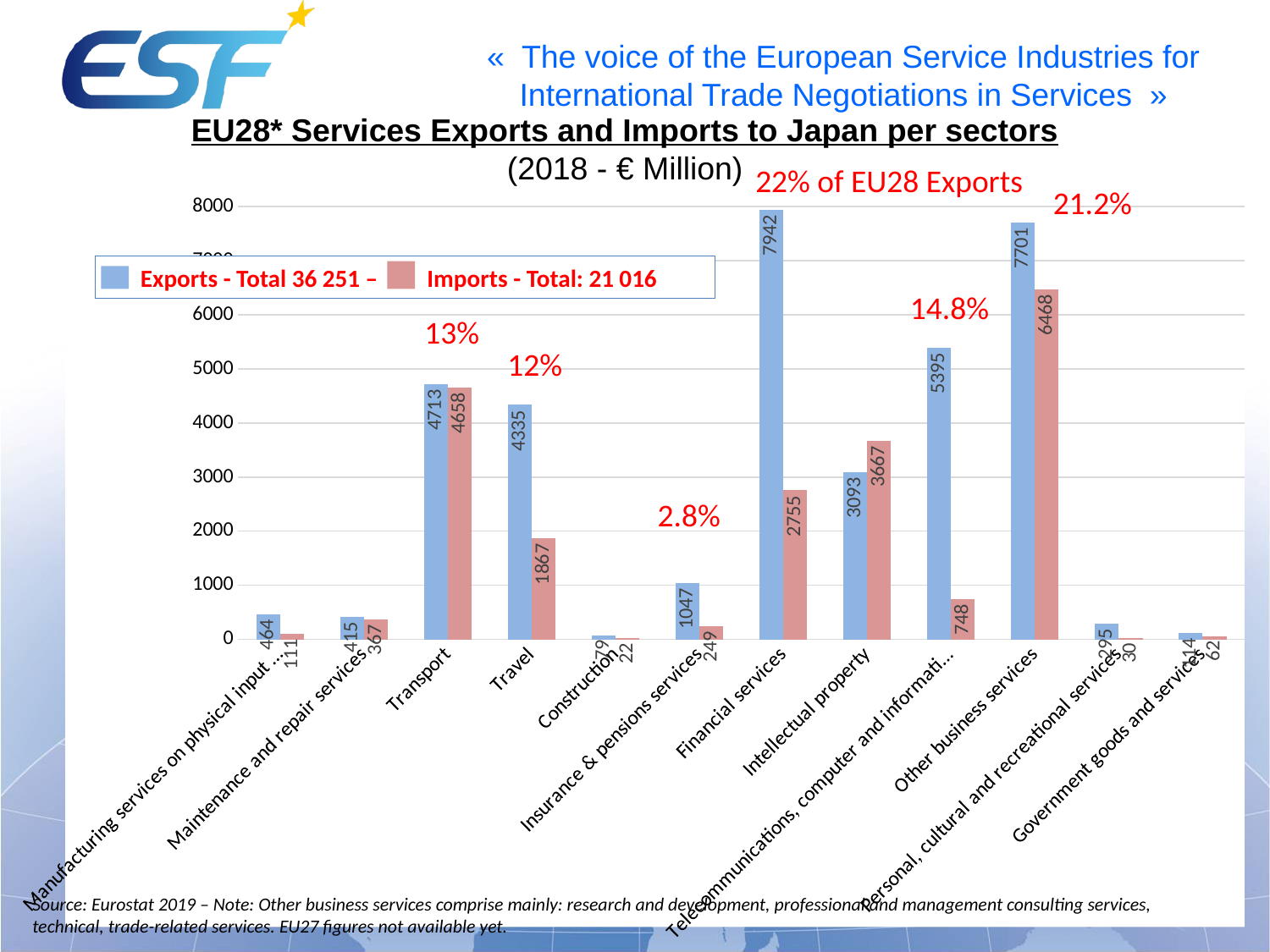
What is the value of Exports for Financial services? 7942 Which sector has the highest Exports value? Financial services What type of chart is shown? Bar chart How many series does the legend list? 2 What is the value of Exports for Telecommunications, computer and information services? 5395 What is the difference between Exports and Imports for Financial services? 5187 How many sectors are shown on the x axis? 12 Is the Exports value for Transport greater or less than 4000? greater Which is larger for Intellectual property, Exports or Imports? Imports What is the value of Imports for Other business services? 6468 What is the value of Imports for Travel? 1867 Which sector has the highest Imports value? Other business services